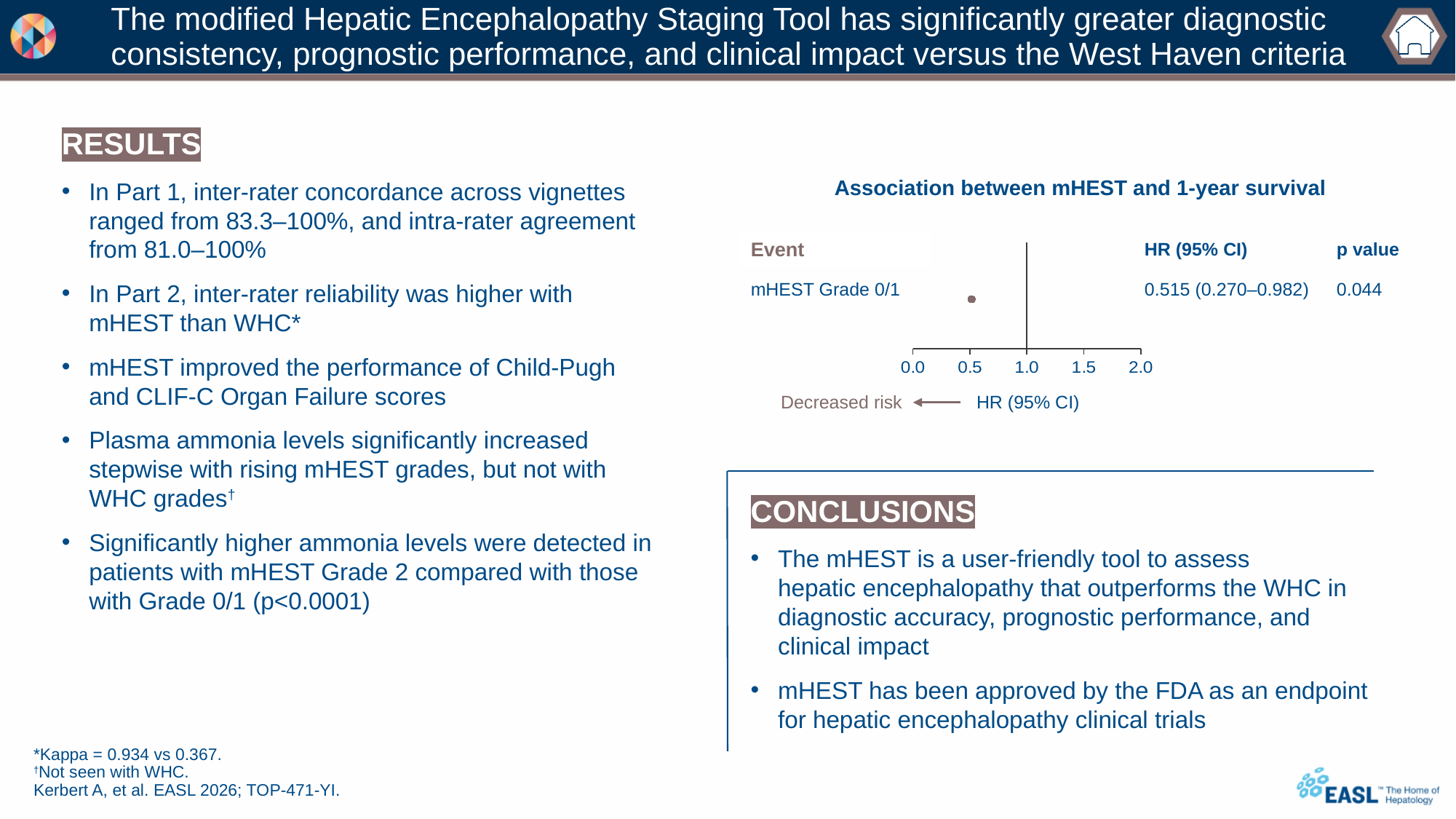
What is the HR (95% CI) shown for mHEST Grade 0/1 in the chart? 0.515 (0.270–0.982) What is the title of the chart on the slide? Association between mHEST and 1-year survival How many events are plotted in the forest plot? 1 Is the hazard ratio for mHEST Grade 0/1 greater or less than 0.5? greater What is the highest value shown on the x axis of the chart? 2.0 Which event is listed in the forest plot? mHEST Grade 0/1 What is the p value shown for mHEST Grade 0/1 in the chart? 0.044 What is the lower bound of the 95% CI for mHEST Grade 0/1? 0.270 What is the upper bound of the 95% CI for mHEST Grade 0/1? 0.982 Is the hazard ratio for mHEST Grade 0/1 greater or less than 1.0? less